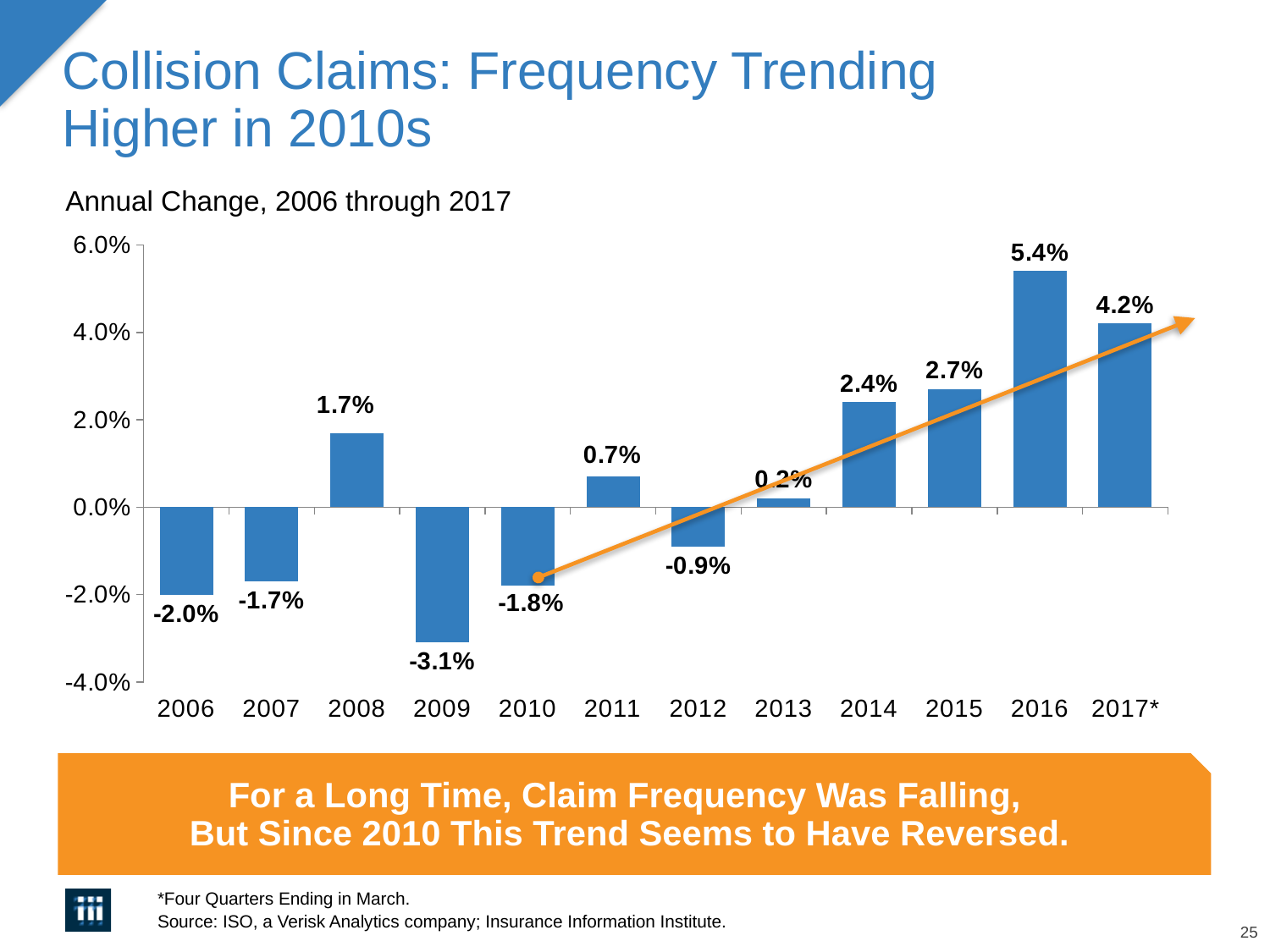
Do the annual change values generally rise or fall from 2010 to 2016? Rise Is the value for 2014 greater or less than 2.0%? greater What kind of chart is used to show the annual change in collision claim frequency? Bar chart Which year has the highest annual change in collision claim frequency? 2016 What is the annual change in collision claim frequency for 2012? -0.9% How many years are shown on the x axis of the chart? 12 What is the difference between the annual change in 2016 and the annual change in 2015? 2.7% What is the annual change in collision claim frequency for 2009? -3.1% Which year has a larger annual change, 2008 or 2011? 2008 What is the annual change in collision claim frequency for 2017*? 4.2% What is the annual change in collision claim frequency for 2016? 5.4% Which year has the lowest annual change in collision claim frequency? 2009